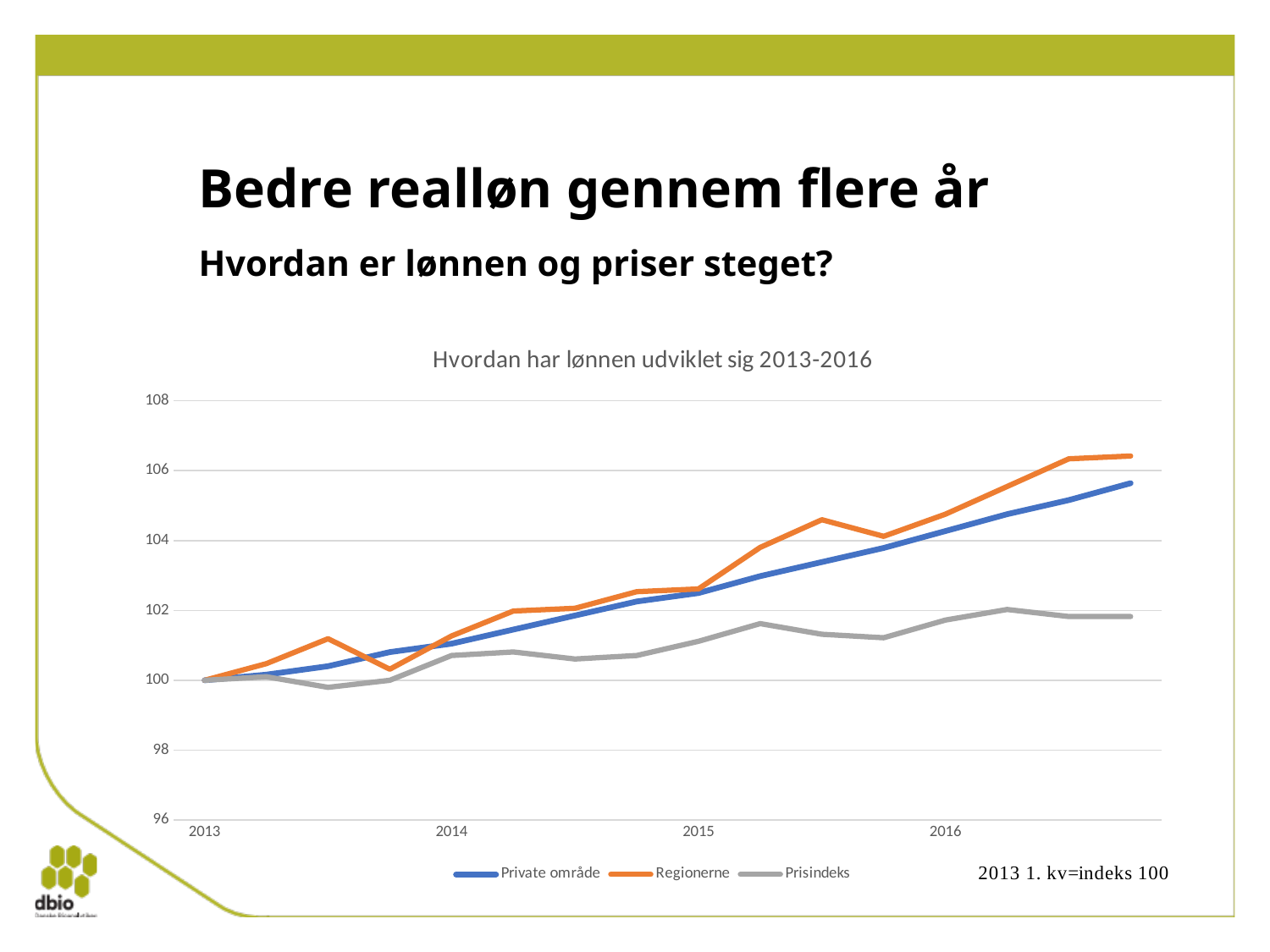
Does the Private område line rise or fall from 2013 to the end of 2016? rise What kind of chart is shown on the slide? line chart Is the final value of the Prisindeks line greater or less than 102? less Is the value of the Prisindeks line at 2016 greater or less than 100? greater What is the title of the chart? Hvordan har lønnen udviklet sig 2013-2016 Is the final value of the Private område line greater or less than 106? less At the end of the period, which line is higher: Regionerne or Private område? Regionerne How many series does the legend list? 3 Which series is shown in orange in the legend? Regionerne Which series has the lowest value at the end of the period? Prisindeks How many year labels are shown on the x axis? 4